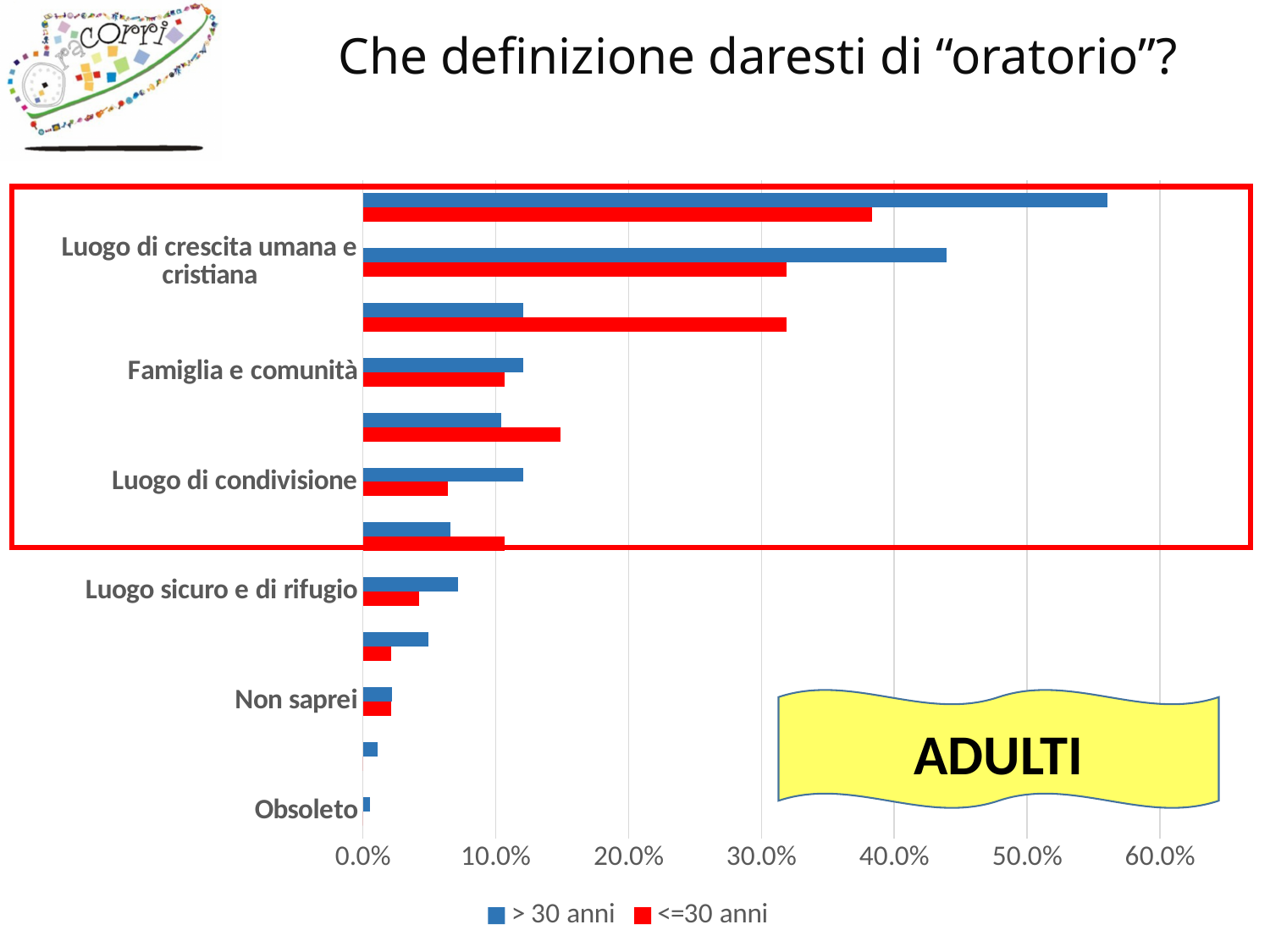
Among the labeled categories, which has the lowest > 30 anni value? Obsoleto Is the > 30 anni value for "Luogo di crescita umana e cristiana" greater or less than 40.0%? greater Among the labeled categories, which has the highest > 30 anni value? Luogo di crescita umana e cristiana For "Luogo di crescita umana e cristiana", which series has the larger value, > 30 anni or <=30 anni? > 30 anni How many series does the legend list? 2 What colour are the bars for the <=30 anni series? Red What are the two series named in the legend? > 30 anni and <=30 anni Is the > 30 anni value for "Famiglia e comunità" greater or less than 20.0%? less Is the <=30 anni value for "Luogo di crescita umana e cristiana" greater or less than 40.0%? less What kind of chart is shown on the slide? Bar chart For "Luogo sicuro e di rifugio", which series has the larger value, > 30 anni or <=30 anni? > 30 anni